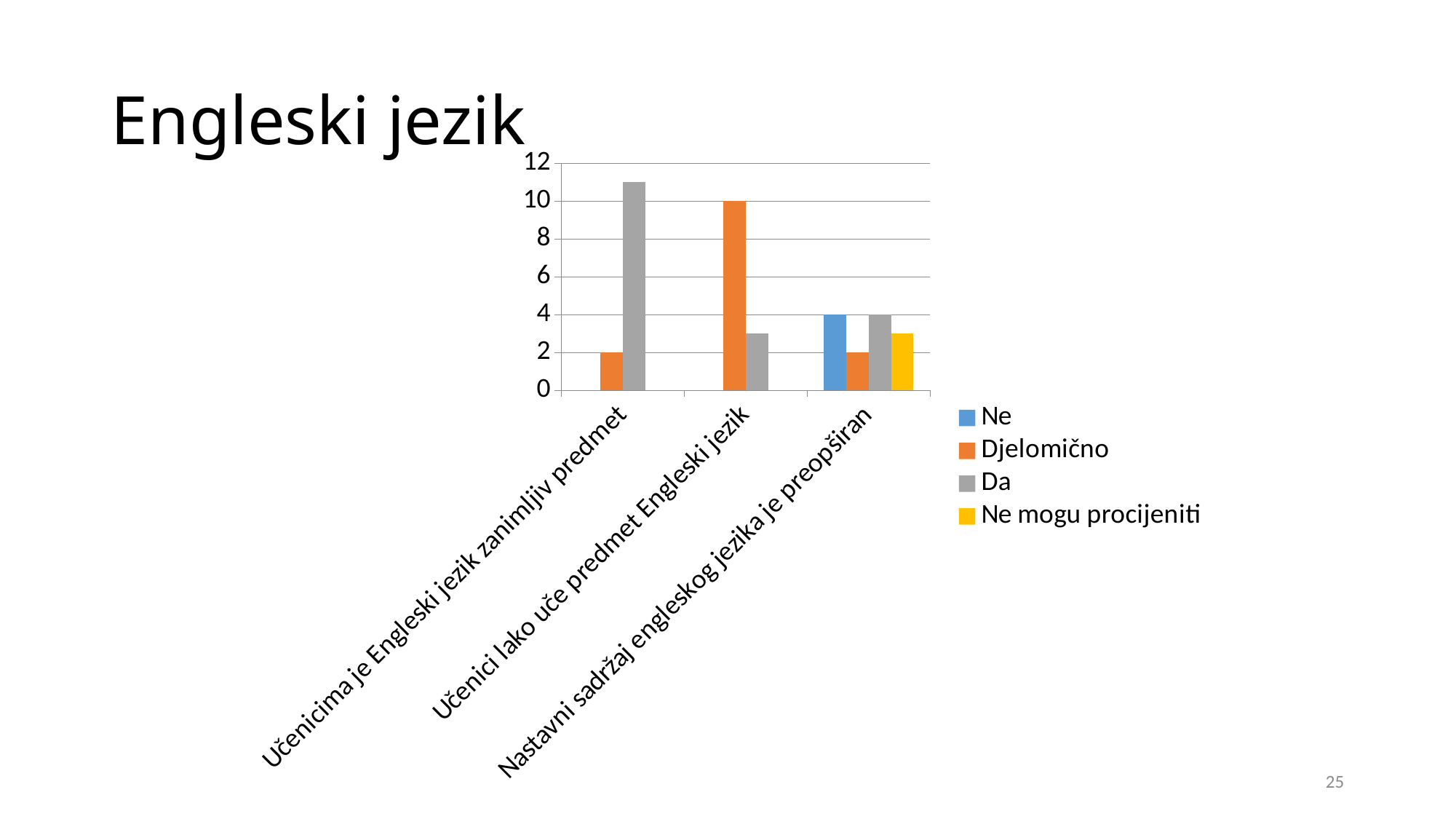
Is the value of 'Da' for 'Učenicima je Engleski jezik zanimljiv predmet' greater or less than 10? greater What is the value of 'Ne' for 'Nastavni sadržaj engleskog jezika je preopširan'? 4 What is the value of 'Djelomično' for 'Učenici lako uče predmet Engleski jezik'? 10 What is the title of the slide? Engleski jezik What is the difference between the 'Djelomično' values for 'Učenici lako uče predmet Engleski jezik' and 'Učenicima je Engleski jezik zanimljiv predmet'? 8 How many categories are shown on the x axis? 3 What kind of chart is shown on the slide? bar chart Is the value of 'Da' for 'Učenici lako uče predmet Engleski jezik' greater or less than 4? less How many series does the legend list? 4 For 'Učenici lako uče predmet Engleski jezik', which is larger: 'Djelomično' or 'Da'? Djelomično Which series has the highest bar in the whole chart? Da What is the value of 'Djelomično' for 'Učenicima je Engleski jezik zanimljiv predmet'? 2